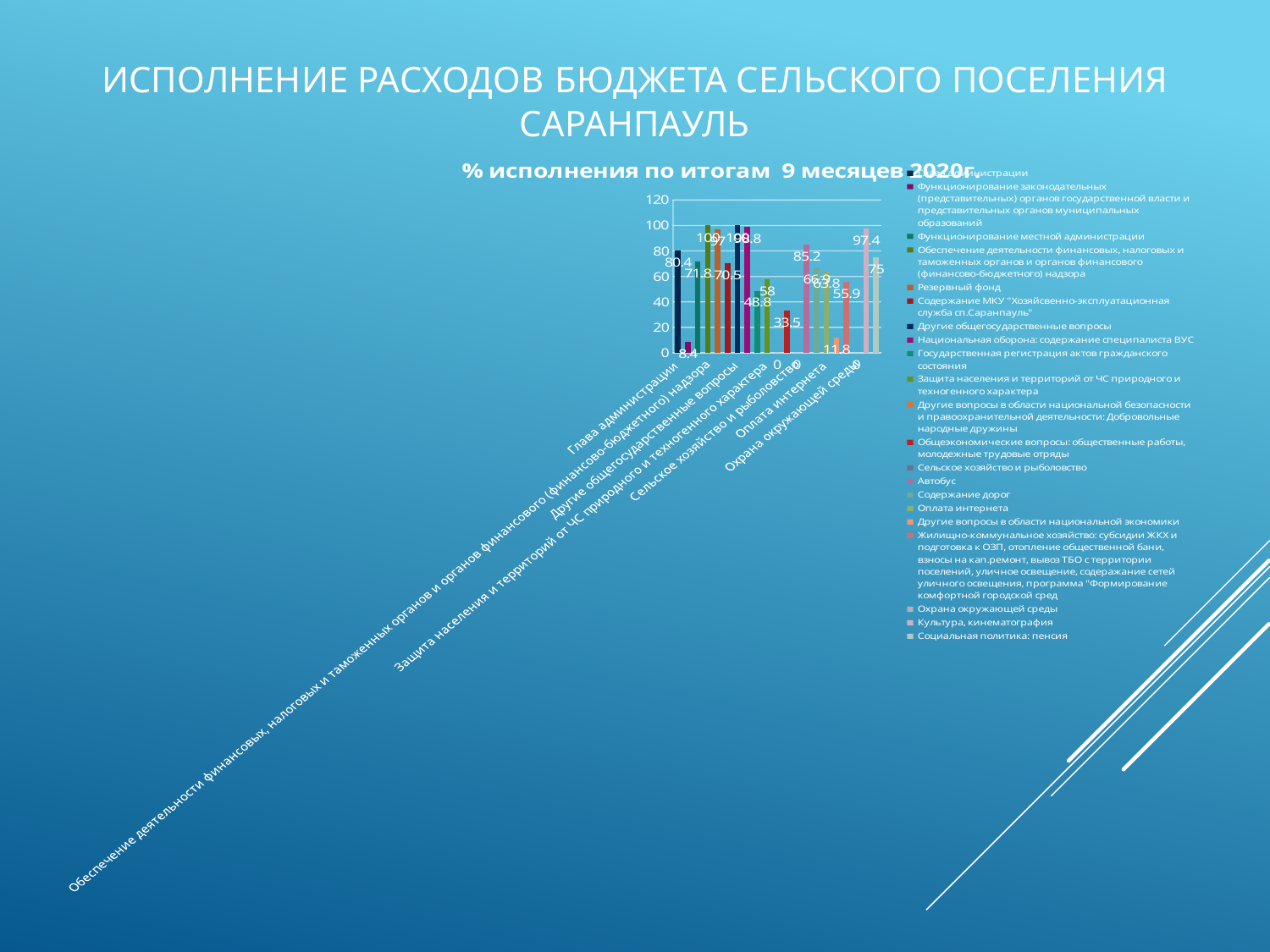
What is the value for Социальная политика: пенсия? 75 What is the maximum value shown on the vertical axis? 120 What is the value for Культура, кинематография? 97.4 What is the lowest value shown in the chart? 0 What kind of chart is shown on the slide? bar chart What is the difference between the highest value (100) and the value for Глава администрации? 19.6 What is the title of the chart? % исполнения по итогам 9 месяцев 2020г. What is the value for Глава администрации? 80.4 Which is larger, the value for Глава администрации or the value for Социальная политика: пенсия? Глава администрации What is the highest value shown in the chart? 100 How many entries does the chart legend list? 21 What is the value for Автобус? 85.2